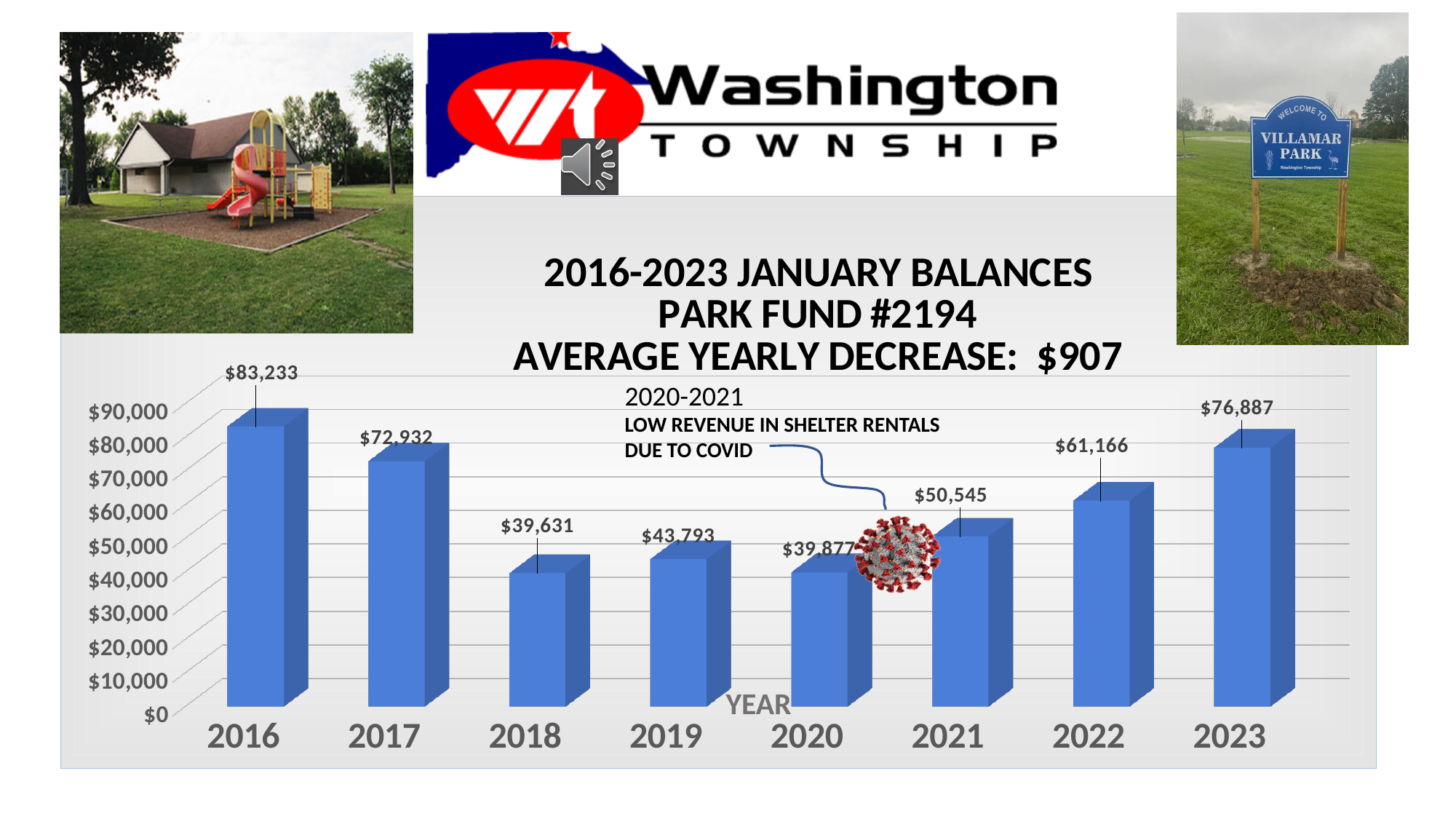
Which year has the highest January balance? 2016 Which year has the larger January balance, 2019 or 2022? 2022 How many years are shown on the chart? 8 What kind of chart is shown on the slide? bar chart What average yearly decrease is stated in the chart title? $907 What is the difference between the 2023 and 2022 January balances? $15,721 What is the January balance for 2021? $50,545 What is the January balance for 2016? $83,233 Do the January balances rise or fall from 2020 to 2023? rise What is the January balance for 2023? $76,887 Is the value for 2019 greater or less than $40,000? greater What is the difference between the 2016 and 2017 January balances? $10,301